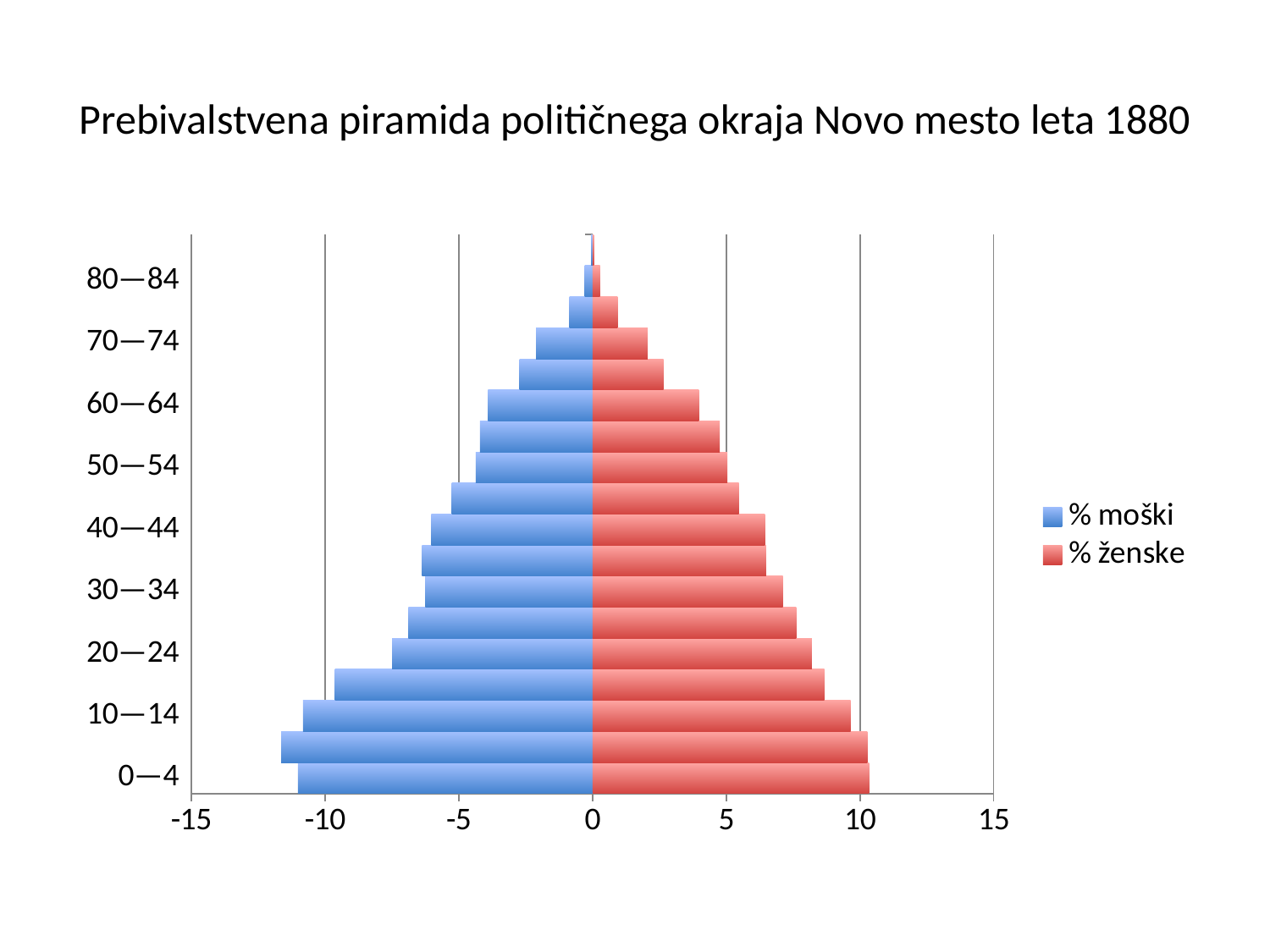
Is the % ženske value for 20—24 greater or less than 10? less Which series is shown in red? % ženske Which age group has the longer % ženske bar, 0—4 or 20—24? 0—4 How many series does the legend list? 2 Is the % ženske value for 10—14 greater or less than 5? greater Do the bars get longer or shorter as the age groups increase from 0—4 to 80—84? shorter What kind of chart is shown on the slide? Bar chart (population pyramid) What is the title of the chart? Prebivalstvena piramida političnega okraja Novo mesto leta 1880 How many age-group labels are shown on the vertical axis? 9 Is the % ženske value for 70—74 greater or less than 5? less Which age group has the longer % moški bar, 10—14 or 30—34? 10—14